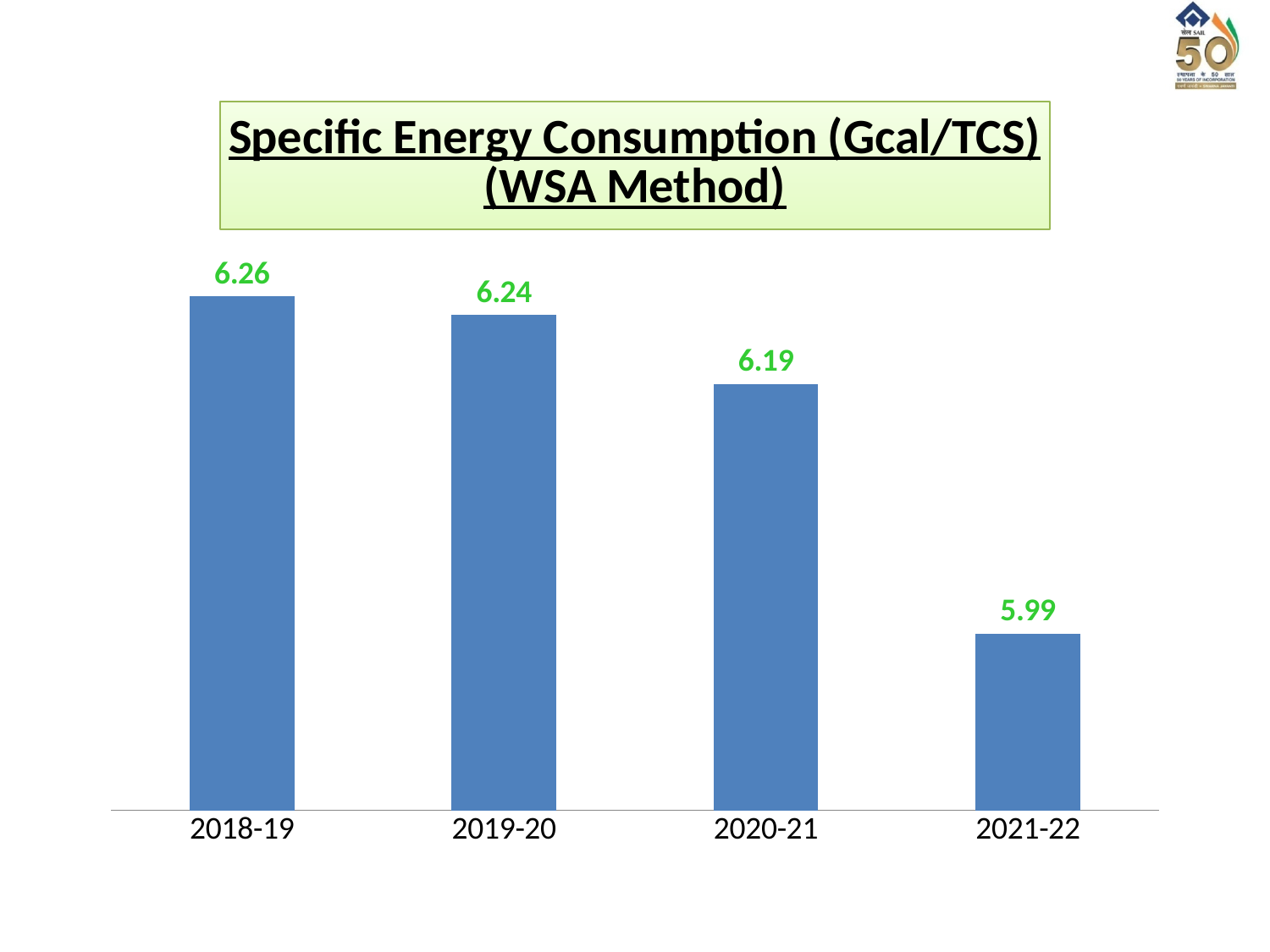
Which year has the lowest specific energy consumption? 2021-22 Do the values rise or fall from 2018-19 to 2021-22? Fall Which year has a higher specific energy consumption, 2020-21 or 2021-22? 2020-21 How many years are shown on the chart? 4 What is the specific energy consumption for 2018-19? 6.26 What kind of chart is shown on the slide? Bar chart What is the specific energy consumption for 2021-22? 5.99 What is the specific energy consumption for 2020-21? 6.19 What is the difference in specific energy consumption between 2019-20 and 2020-21? 0.05 What is the difference in specific energy consumption between 2018-19 and 2021-22? 0.27 Which year has the highest specific energy consumption? 2018-19 What is the specific energy consumption for 2019-20? 6.24